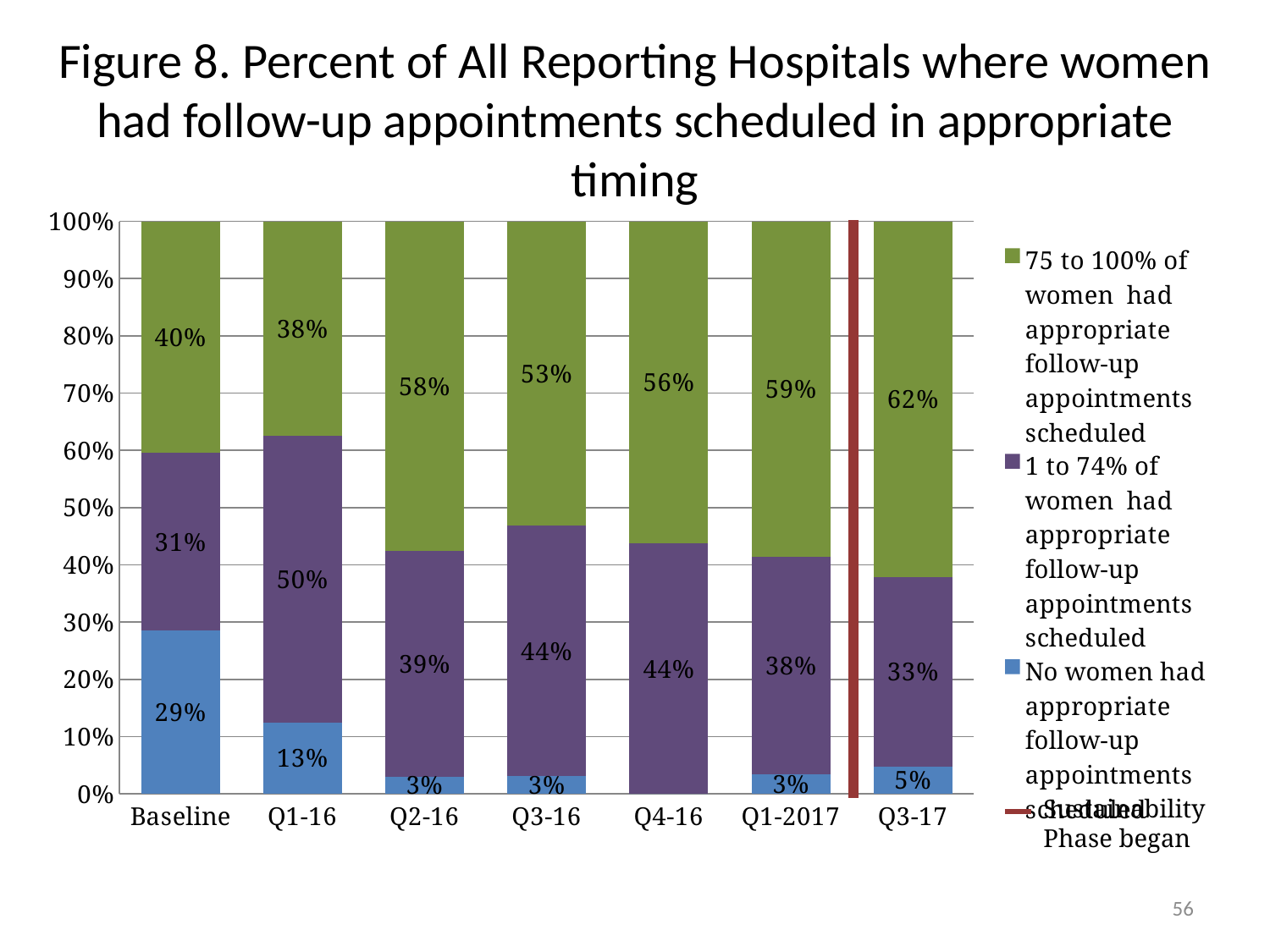
What is the value for the '1 to 74% of women' series in Q1-16? 50% Which period has a larger value for the '1 to 74% of women' series, Q3-16 or Q1-2017? Q3-16 Does the 'No women had appropriate follow-up appointments scheduled' value rise or fall from Baseline to Q2-16? Fall At Baseline, what percentage of hospitals had no women with appropriate follow-up appointments scheduled? 29% What kind of chart is shown on the slide? Stacked bar chart How many time periods are shown on the x axis? 7 Which period has the highest value for the '75 to 100% of women' series? Q3-17 By how many percentage points does the '75 to 100% of women' value in Q3-17 exceed the Baseline value? 22 percentage points What is the value for the 'No women had appropriate follow-up appointments scheduled' series in Q3-17? 5% Which period has the lowest value for the '75 to 100% of women' series? Q1-16 How many entries does the legend list? 4 What percentage of hospitals had 75 to 100% of women with appropriate follow-up appointments scheduled in Q3-17? 62%